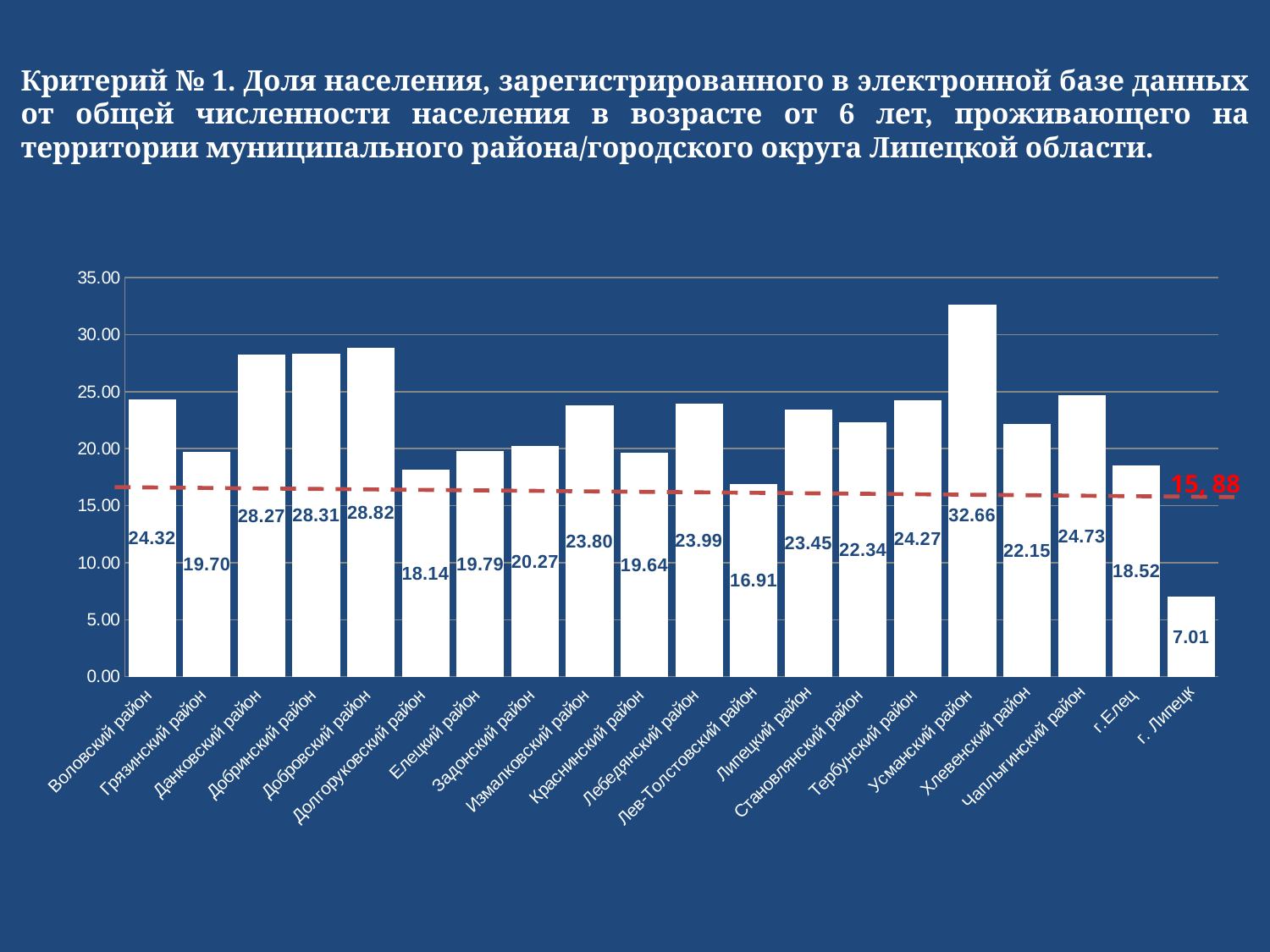
What is the difference between the values for Усманский район and г. Липецк? 25.65 What is the value for Усманский район? 32.66 What kind of chart is shown on the slide? bar chart What value is marked by the red dashed line? 15.88 Which category has the highest value? Усманский район What is the value for г. Липецк? 7.01 Which category has the lowest value? г. Липецк Is the value for Долгоруковский район greater or less than 20.00? less Which is larger, the value for Добровский район or the value for Данковский район? Добровский район What is the value for г.Елец? 18.52 How many categories are shown on the x axis? 20 What is the value for Лев-Толстовский район? 16.91